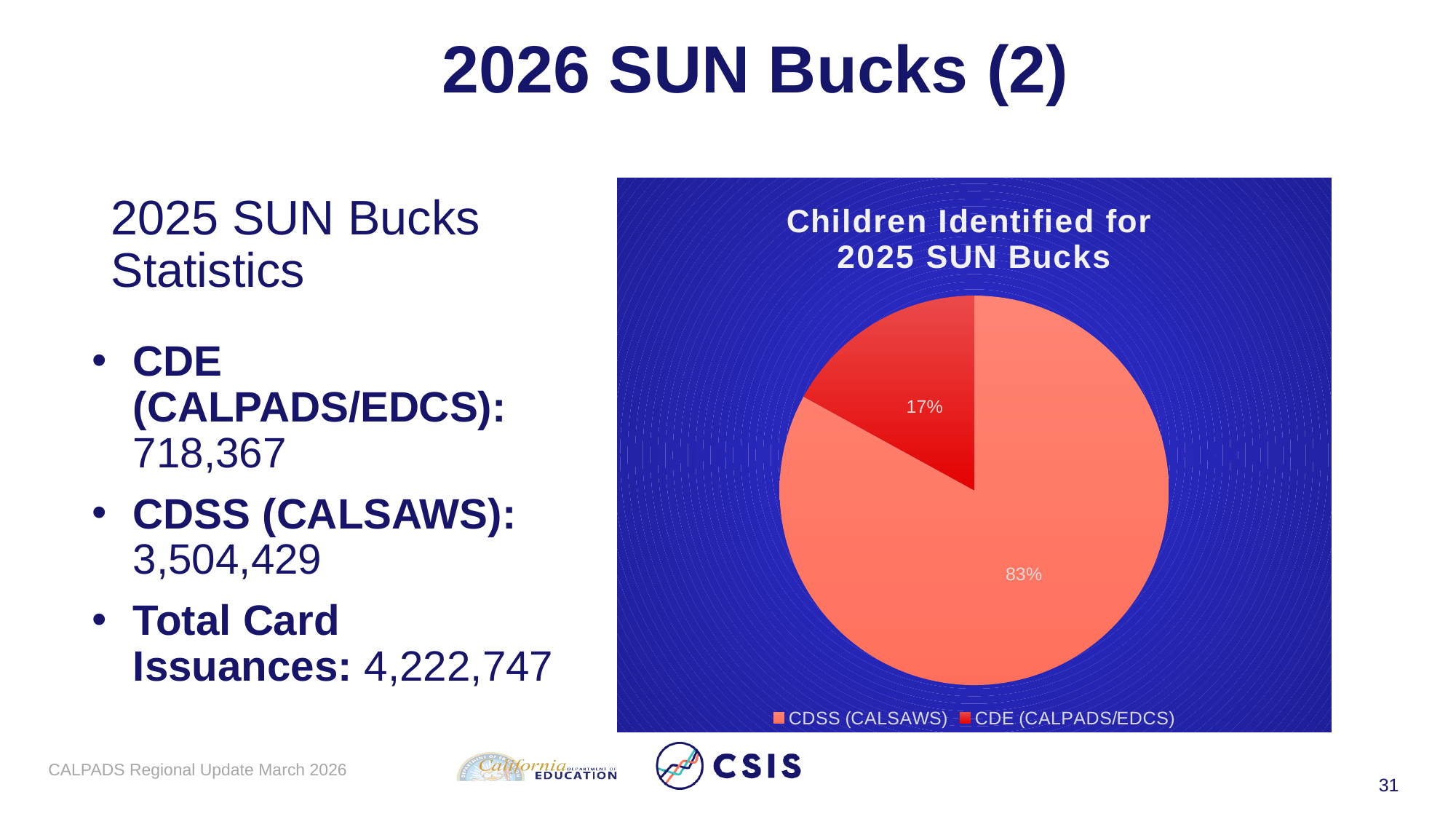
Which category has the smallest slice of the pie? CDE (CALPADS/EDCS) What is the difference in percentage points between the CDSS (CALSAWS) slice and the CDE (CALPADS/EDCS) slice? 66 percentage points What is the title of the chart? Children Identified for 2025 SUN Bucks Which category has the largest slice of the pie? CDSS (CALSAWS) What type of chart is shown on the slide? pie chart How many entries does the legend list? 2 How many categories does the pie chart show? 2 Which colour represents CDE (CALPADS/EDCS) in the pie chart? red What share of the pie does CDE (CALPADS/EDCS) represent? 17% What share of the pie does CDSS (CALSAWS) represent? 83% Which is larger, the CDE (CALPADS/EDCS) slice or the CDSS (CALSAWS) slice? CDSS (CALSAWS)